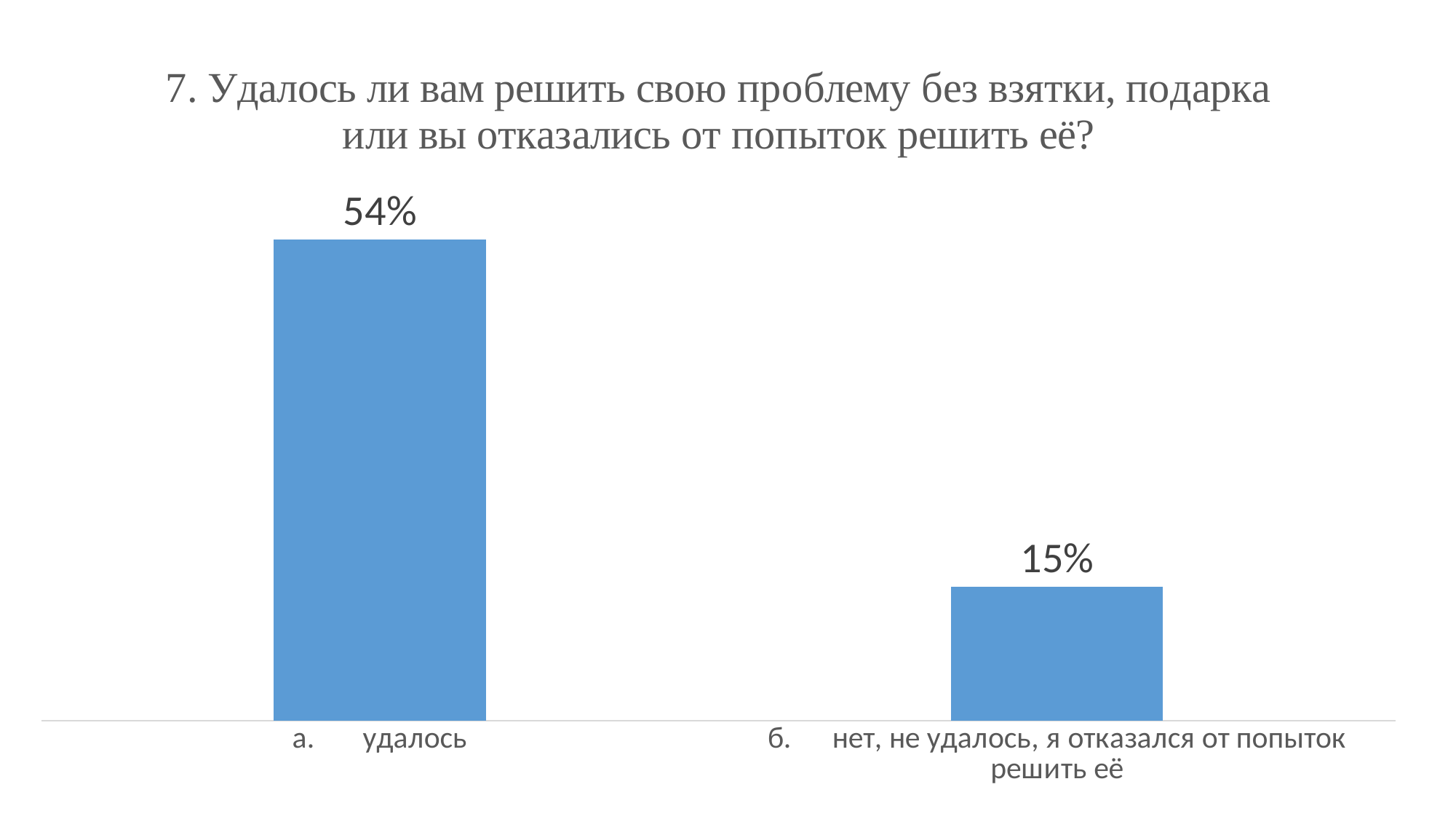
Do the values rise or fall from left to right along the x axis? Fall What colour are the bars in the chart? Blue Which category has the lowest value? б. нет, не удалось, я отказался от попыток решить её What is the difference between the values for "а. удалось" and "б. нет, не удалось, я отказался от попыток решить её"? 39% Which is larger: the value for "а. удалось" or the value for "б. нет, не удалось, я отказался от попыток решить её"? а. удалось What is the value for "а. удалось"? 54% Which category has the highest value? а. удалось What is the value for "б. нет, не удалось, я отказался от попыток решить её"? 15% What is the title of the chart? 7. Удалось ли вам решить свою проблему без взятки, подарка или вы отказались от попыток решить её? How many categories are shown in the chart? 2 What kind of chart is shown on the slide? Bar chart